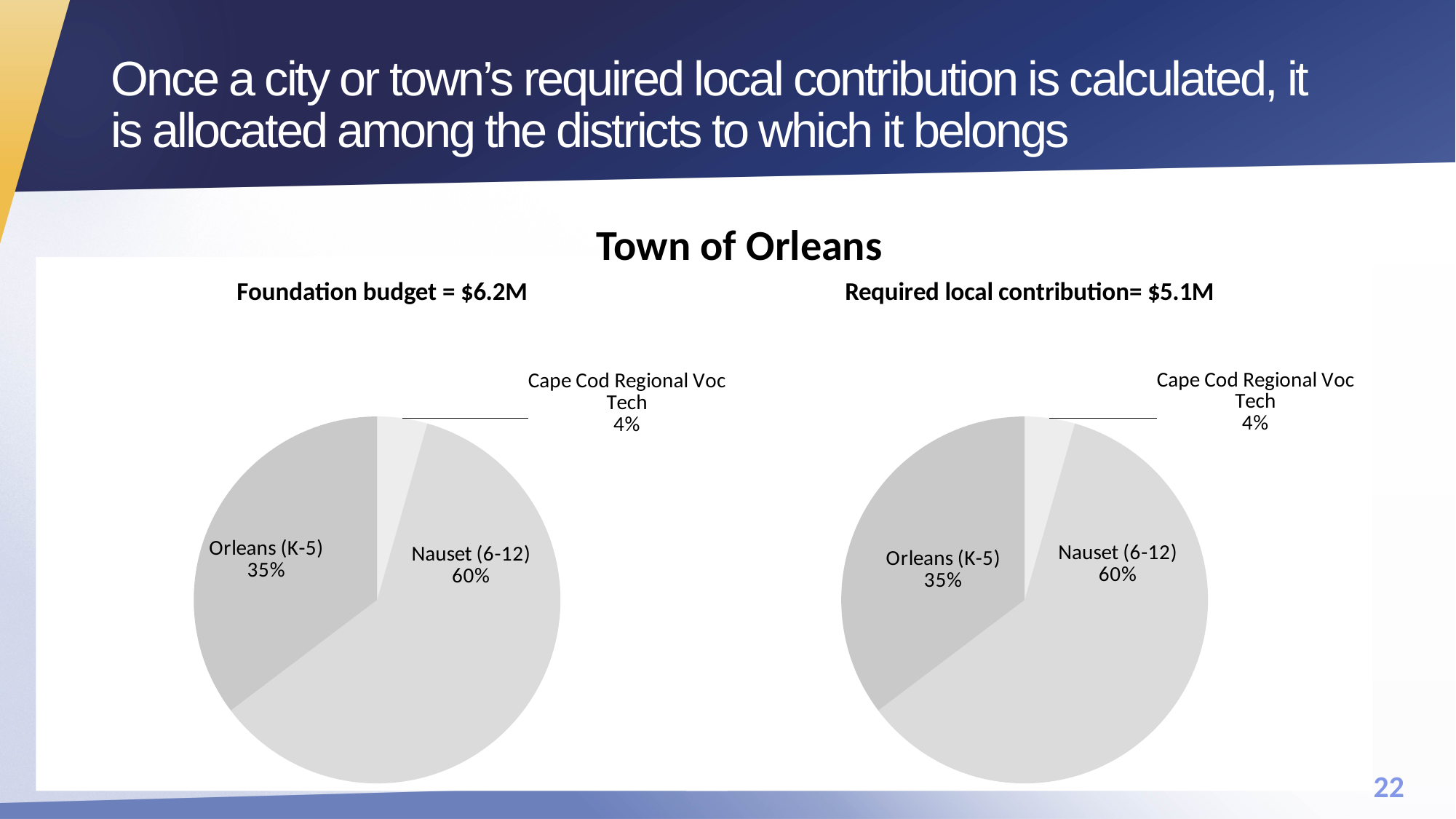
In the 'Foundation budget = $6.2M' pie chart, what share does Nauset (6-12) have? 60% In the 'Foundation budget = $6.2M' pie chart, what share does Cape Cod Regional Voc Tech have? 4% Which town do the two pie charts on the slide describe? Town of Orleans In the 'Foundation budget = $6.2M' pie chart, what is the difference in percentage points between Nauset (6-12) and Orleans (K-5)? 25 What is the title of the left pie chart? Foundation budget = $6.2M What type of chart is used for the 'Required local contribution= $5.1M' chart? Pie chart In the 'Required local contribution= $5.1M' pie chart, which district has the largest slice? Nauset (6-12) In the 'Required local contribution= $5.1M' pie chart, what share does Orleans (K-5) have? 35% In the 'Required local contribution= $5.1M' pie chart, what is the difference in percentage points between Orleans (K-5) and Cape Cod Regional Voc Tech? 31 How many slices does the 'Foundation budget = $6.2M' pie chart have? 3 In the 'Required local contribution= $5.1M' pie chart, which is larger: the Orleans (K-5) slice or the Cape Cod Regional Voc Tech slice? Orleans (K-5) In the 'Foundation budget = $6.2M' pie chart, which district has the smallest slice? Cape Cod Regional Voc Tech